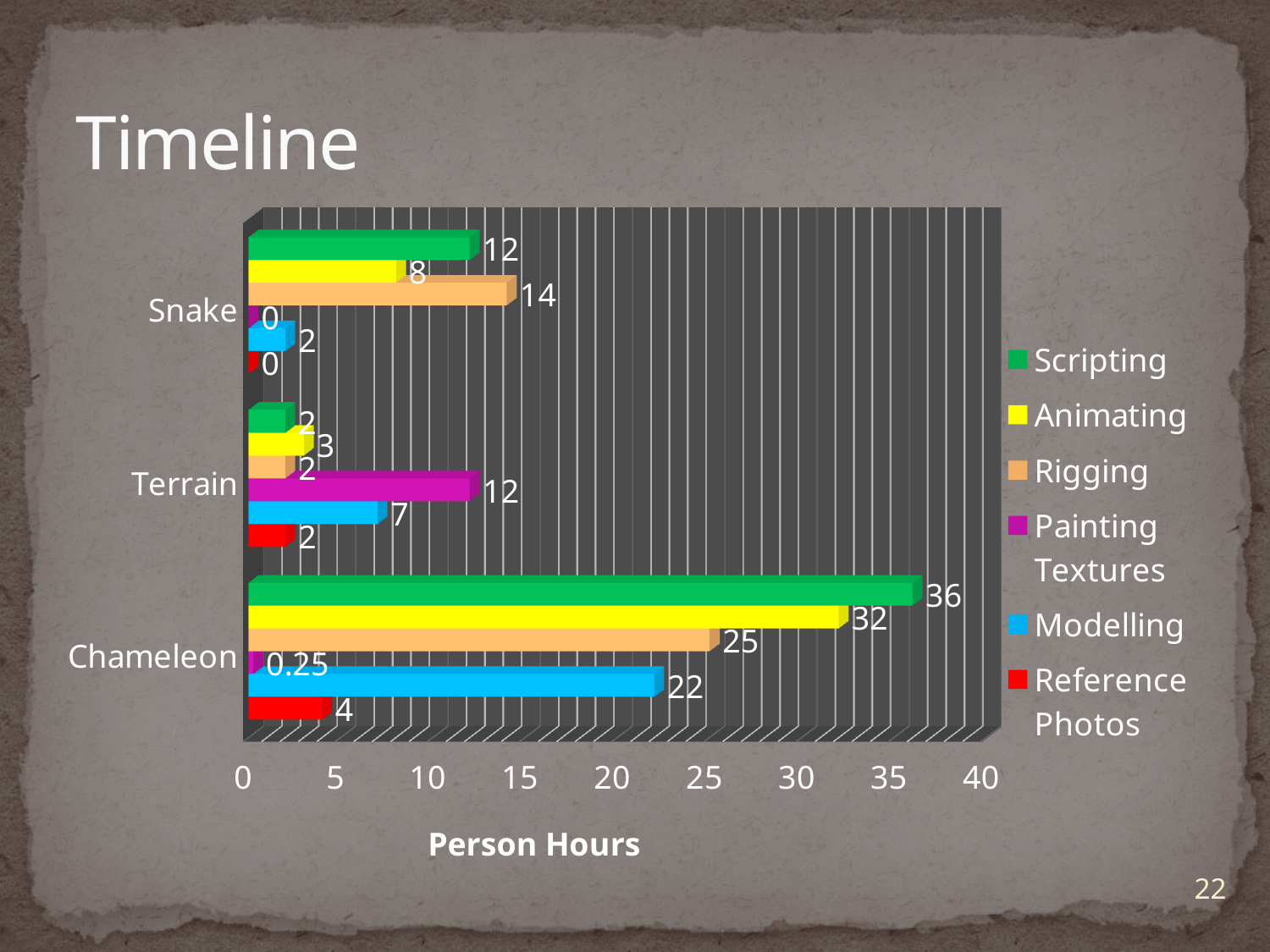
What is the Modelling value for Terrain? 7 Which is larger for Snake, the Animating value or the Rigging value? Rigging What type of chart is shown on the slide? Bar chart What is the Scripting value for Chameleon? 36 What is the Painting Textures value for Chameleon? 0.25 How many categories are shown on the vertical axis? 3 Which series has the lowest value for Terrain? Scripting, Rigging and Reference Photos (all 2) What is the Rigging value for Snake? 14 How many series does the legend list? 6 What is the label of the horizontal axis? Person Hours What is the difference between the Scripting and Animating values for Chameleon? 4 Which category has the highest Scripting value? Chameleon